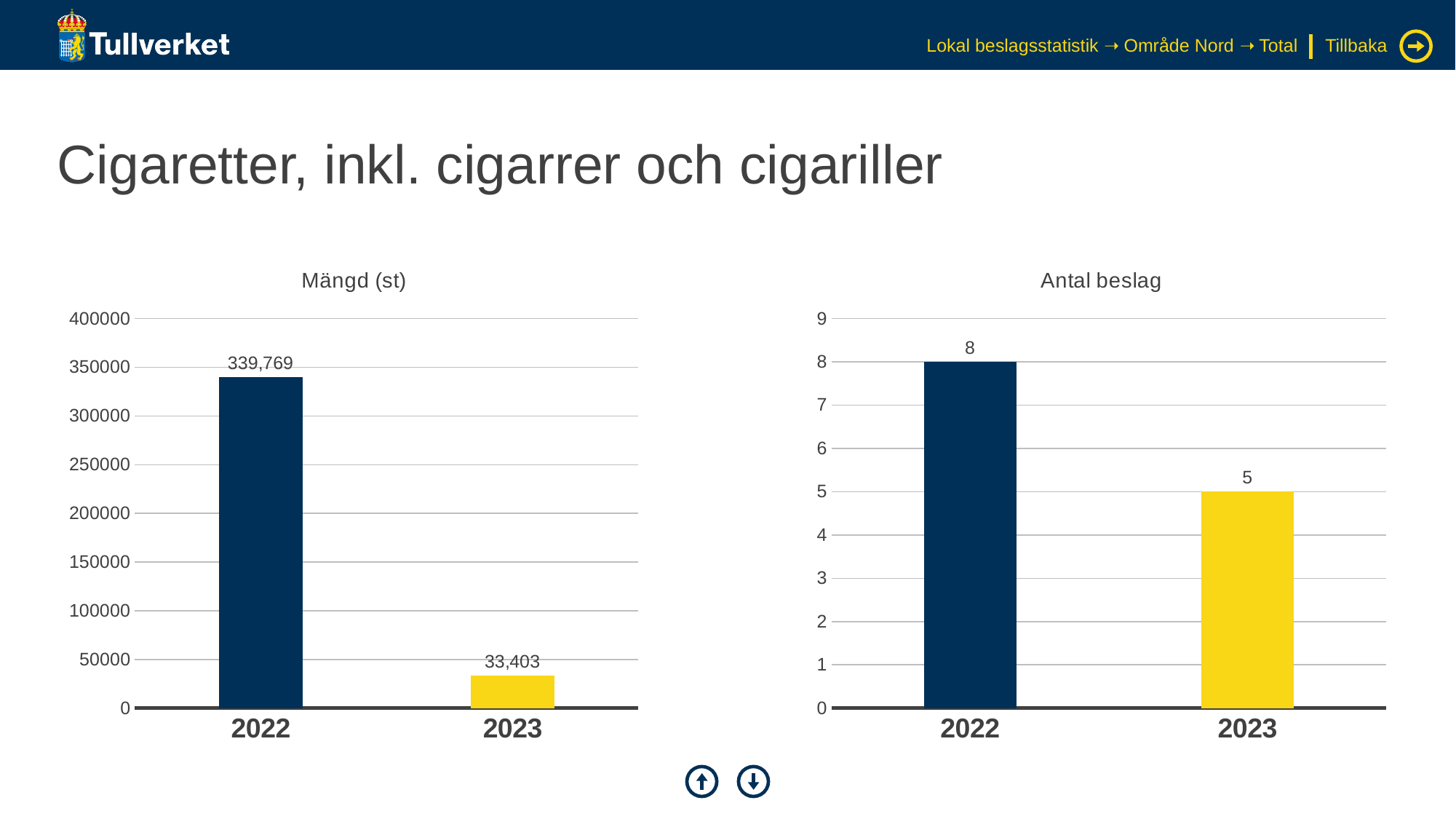
In the 'Antal beslag' chart, what is the difference between the 2022 and 2023 values? 3 What kind of chart is the 'Antal beslag' chart? bar chart In the 'Mängd (st)' chart, what is the value for 2023? 33,403 In the 'Mängd (st)' chart, what is the difference between the 2022 and 2023 values? 306,366 In the 'Mängd (st)' chart, which year has the highest value? 2022 In the 'Mängd (st)' chart, do the values rise or fall from 2022 to 2023? fall In the 'Antal beslag' chart, is the value for 2022 larger or smaller than the value for 2023? larger In the 'Antal beslag' chart, what is the value for 2022? 8 In the 'Antal beslag' chart, what is the value for 2023? 5 In the 'Antal beslag' chart, which year has the lowest value? 2023 In the 'Mängd (st)' chart, is the value for 2023 greater or less than 50000? less In the 'Mängd (st)' chart, what is the value for 2022? 339,769